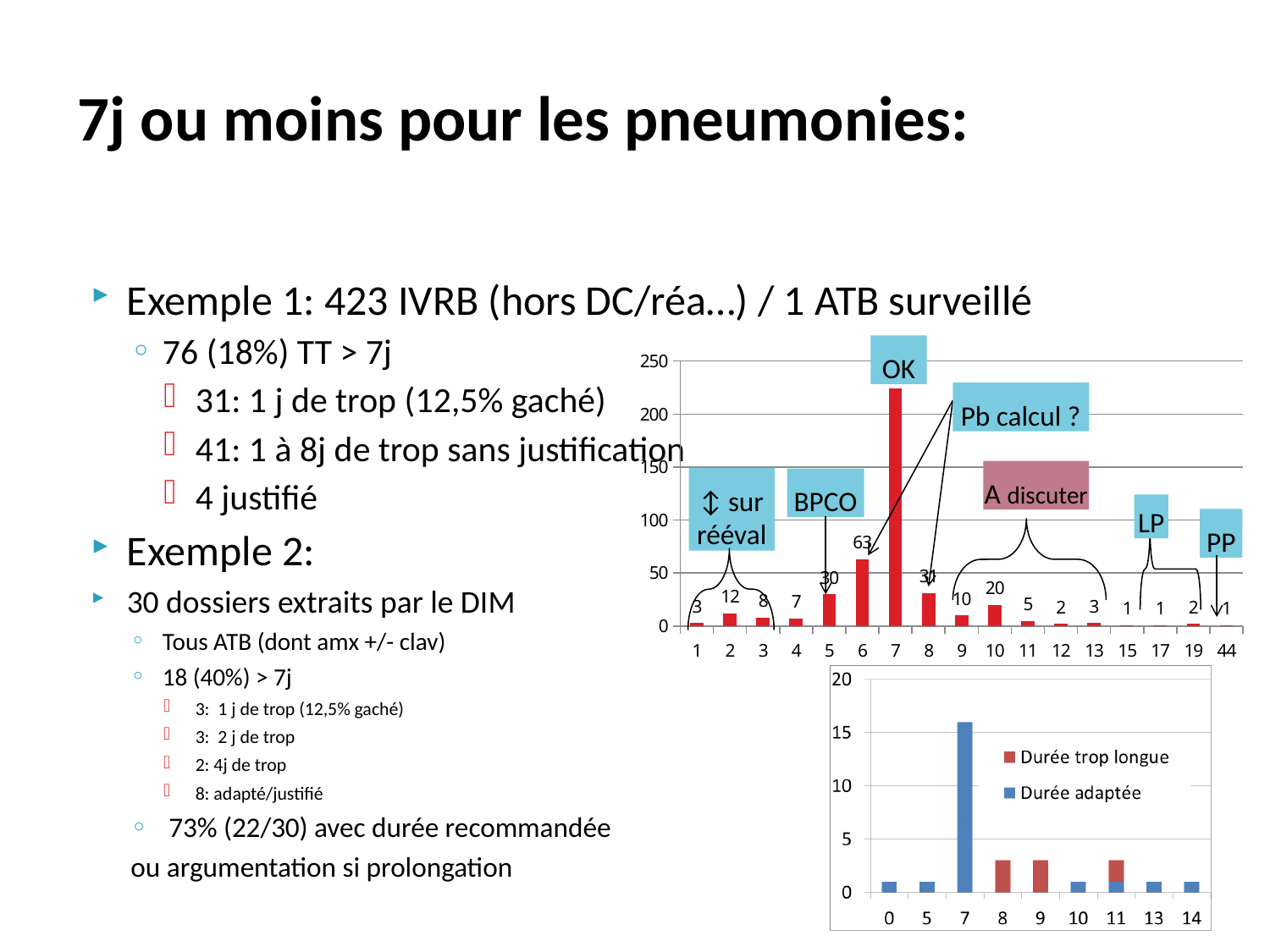
In the top chart, what is the value for category 6? 63 In the bottom chart, is the value of Durée adaptée for category 7 greater or less than 15? greater In the top chart, is the value for category 7 greater or less than 200? greater In the top chart, what is the value for category 10? 20 In the top chart, what is the value for category 2? 12 What kind of chart is the bottom chart? bar chart In the bottom chart, how many series does the legend list? 2 In the top chart, which category has the highest bar? 7 In the top chart, how many categories are shown on the x axis? 17 In the bottom chart, which series is shown in blue? Durée adaptée In the top chart, what is the difference between the values for categories 6 and 10? 43 In the top chart, which has the larger value, category 2 or category 3? 2